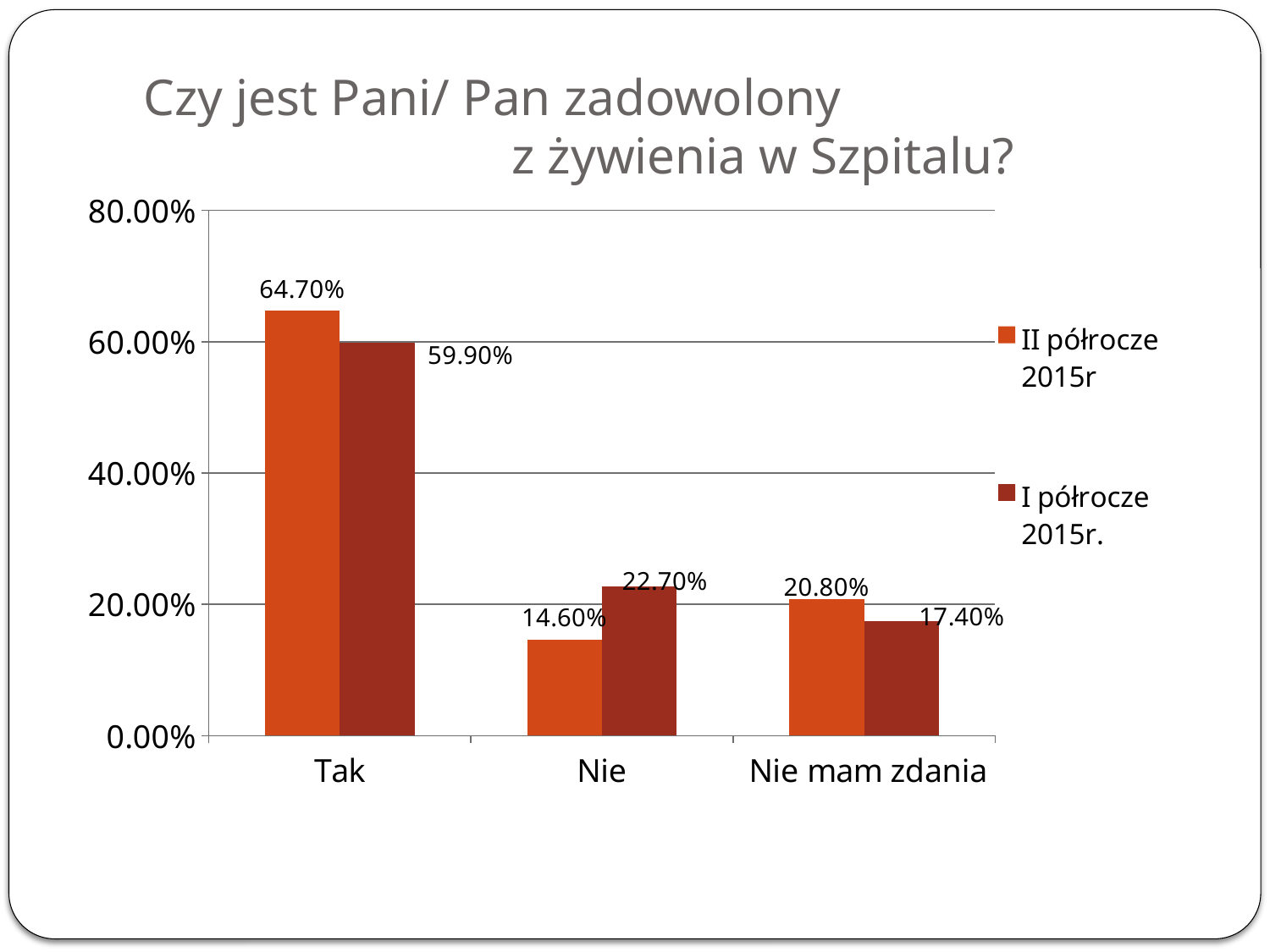
What is the value for "Nie mam zdania" in the "II półrocze 2015r" series? 20.80% How many categories are shown on the x axis? 3 What is the title of the chart? Czy jest Pani/ Pan zadowolony z żywienia w Szpitalu? How many series does the legend list? 2 What is the value for "Tak" in the "II półrocze 2015r" series? 64.70% Is the value for "Nie mam zdania" in the "I półrocze 2015r." series greater or less than 20.00%? less For "Nie", which series has the larger value: "II półrocze 2015r" or "I półrocze 2015r."? I półrocze 2015r. Which category has the lowest value in the "II półrocze 2015r" series? Nie What kind of chart is shown on the slide? bar chart What is the value for "Nie" in the "I półrocze 2015r." series? 22.70% What is the difference between the "II półrocze 2015r" and "I półrocze 2015r." values for "Tak"? 4.80% Which category has the highest value in the "I półrocze 2015r." series? Tak